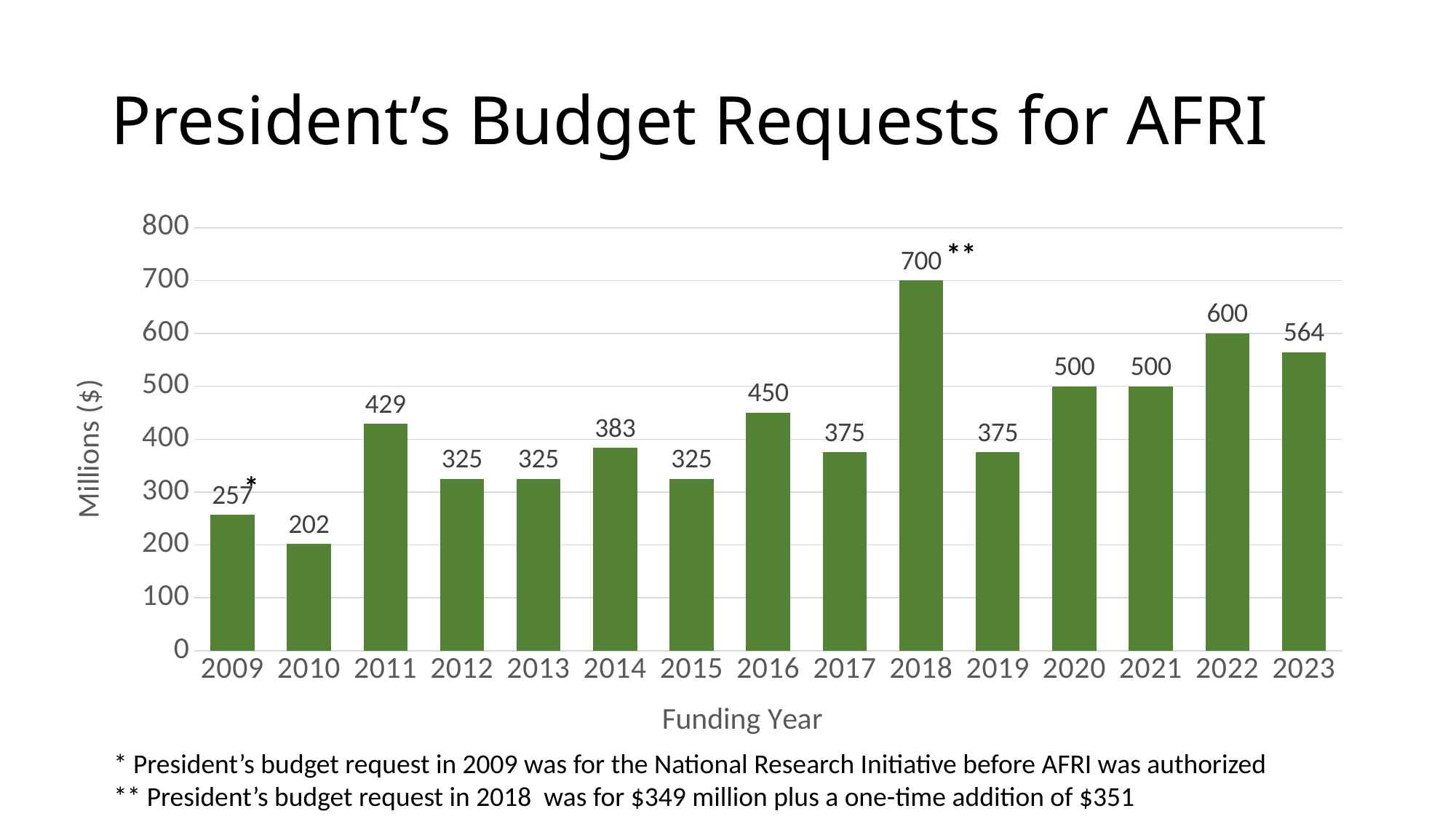
What is the title of the chart? President's Budget Requests for AFRI What is the label of the y axis? Millions ($) What is the difference between the 2011 and 2010 budget requests? 227 What is the difference between the 2022 and 2023 budget requests? 36 What is the value shown for funding year 2023? 564 How many funding years are shown on the chart? 15 Is the value for 2009 greater or less than 300? less Which funding year has the highest budget request? 2018 Which is larger, the budget request for 2014 or for 2017? 2014 What is the President's budget request for AFRI in 2016? 450 What kind of chart is shown on the slide? bar chart Which funding year has the lowest budget request? 2010